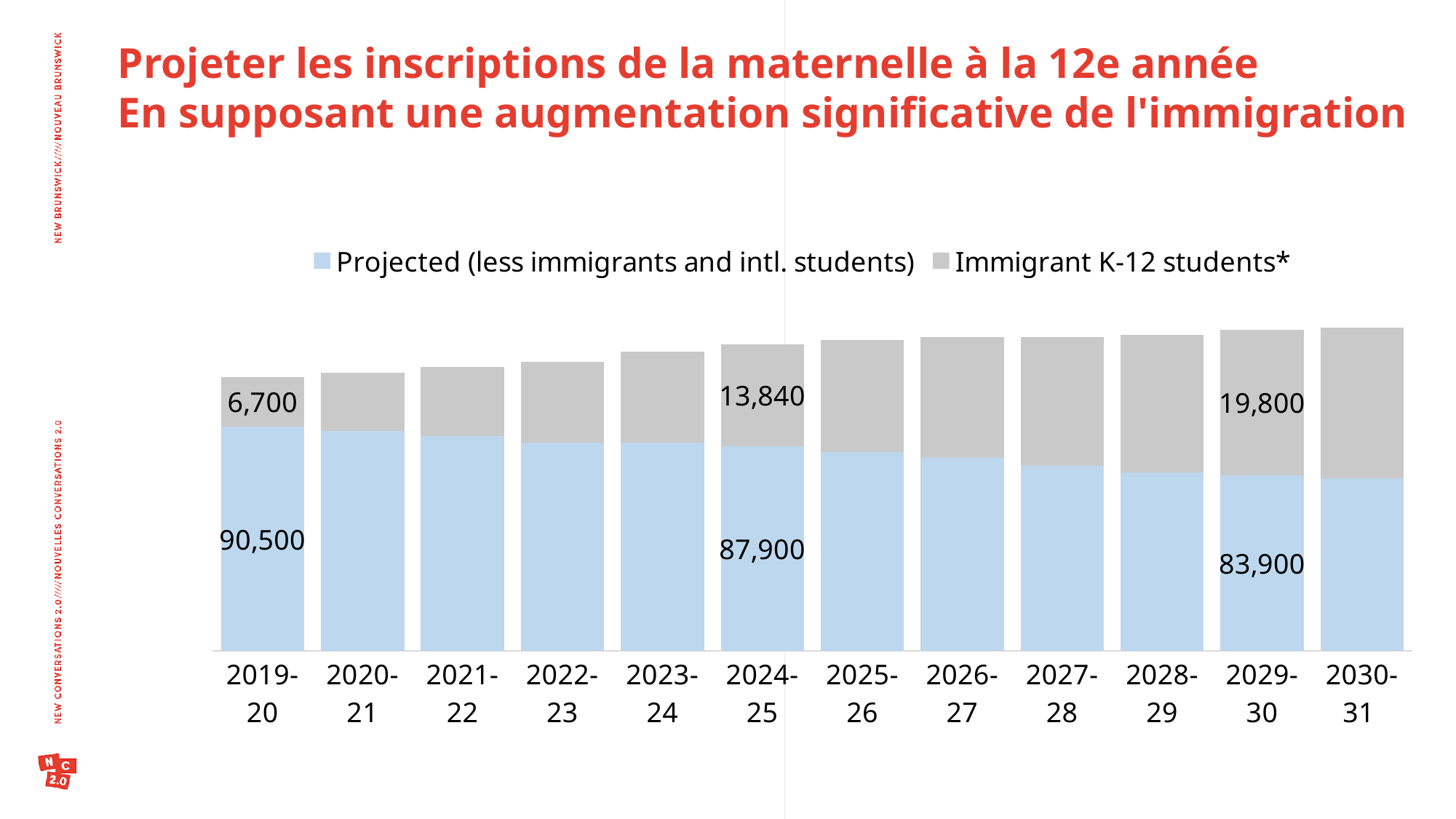
What kind of chart is shown on the slide? stacked bar chart What is the value of 'Immigrant K-12 students*' for 2024-25? 13,840 Which series is shown in grey in the chart? Immigrant K-12 students* What is the value of 'Projected (less immigrants and intl. students)' for 2019-20? 90,500 What is the difference between the 'Immigrant K-12 students*' values for 2029-30 and 2019-20? 13,100 How many series does the chart legend list? 2 What is the total of the stacked bar for 2019-20? 97,200 How many school years are shown along the x axis of the chart? 12 What is the total of the stacked bar for 2029-30? 103,700 What is the value of 'Immigrant K-12 students*' for 2019-20? 6,700 Does the 'Projected (less immigrants and intl. students)' series rise or fall from 2019-20 to 2030-31? fall What is the value of 'Projected (less immigrants and intl. students)' for 2029-30? 83,900